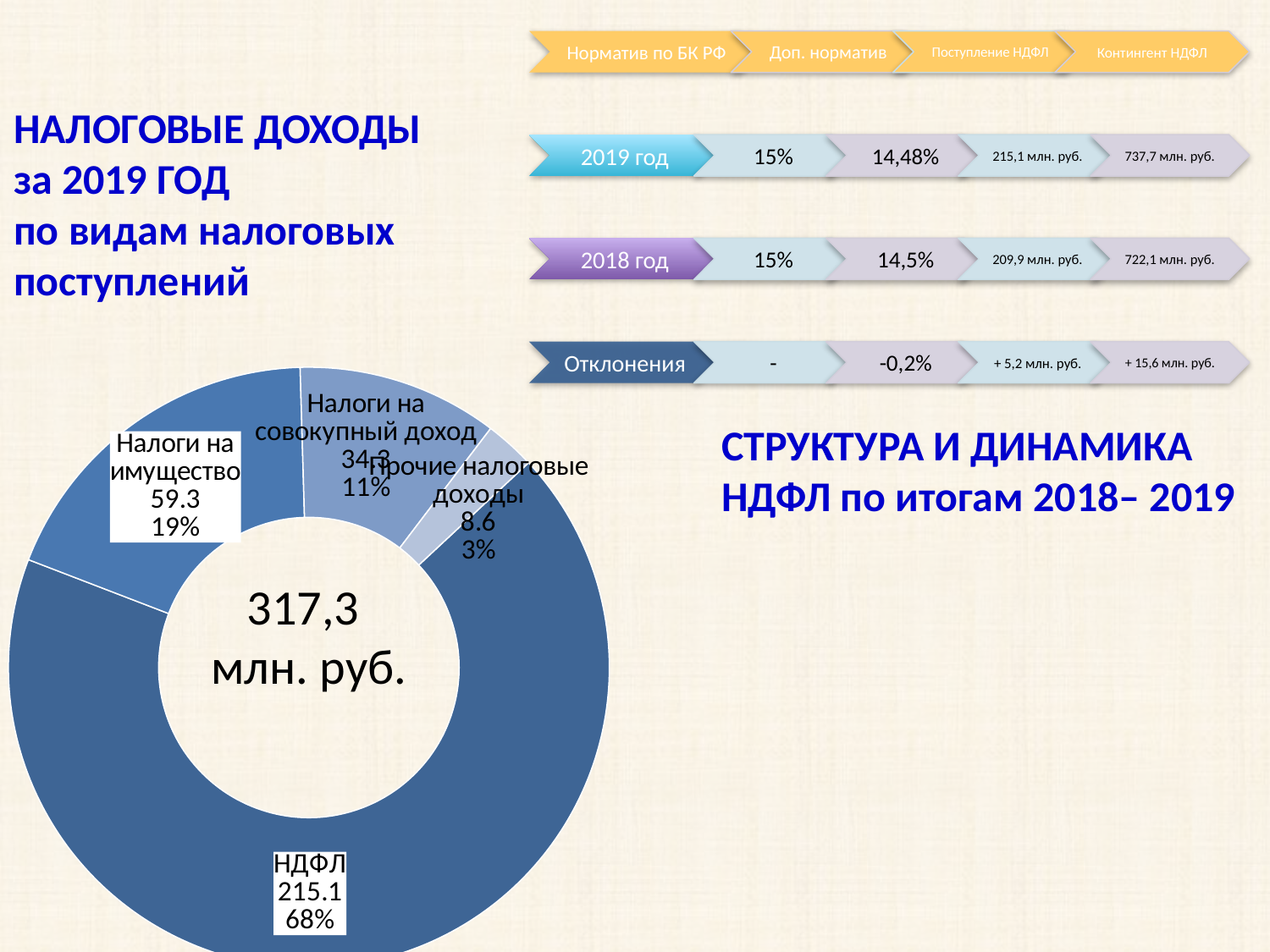
What is the value shown for НДФЛ in the doughnut chart? 215.1 Which category has the largest share in the doughnut chart? НДФЛ Which is larger in the doughnut chart, Налоги на имущество or Прочие налоговые доходы? Налоги на имущество What total is printed in the centre of the doughnut chart? 317,3 млн. руб. Which category has the smallest share in the doughnut chart? Прочие налоговые доходы What share of the doughnut chart does Налоги на совокупный доход account for? 11% How many categories does the doughnut chart show? 4 What is the value shown for Налоги на имущество in the doughnut chart? 59.3 What share of the doughnut chart does НДФЛ account for? 68% What is the value shown for Прочие налоговые доходы in the doughnut chart? 8.6 What kind of chart is shown on the left of the slide? doughnut chart What share of the doughnut chart does Налоги на имущество account for? 19%